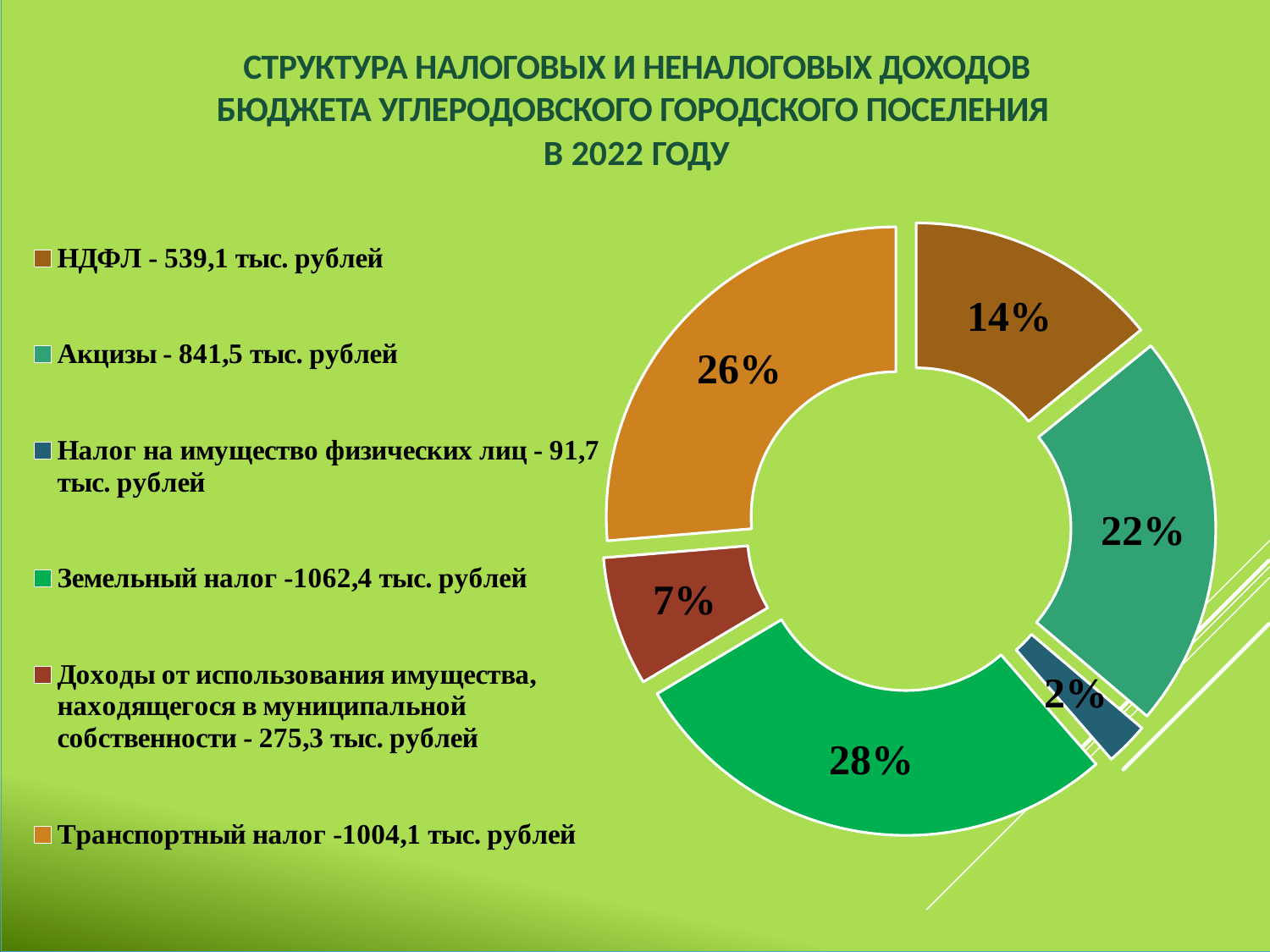
How many categories does the chart show? 6 What percentage is shown for НДФЛ? 14% What share of the chart does Земельный налог account for? 28% What kind of chart is shown on the slide? Doughnut (pie) chart What is the difference in percentage points between the share for Земельный налог and the share for Транспортный налог? 2 percentage points According to the legend, what is the amount for Акцизы? 841,5 тыс. рублей What percentage is shown for Транспортный налог? 26% Which is larger: the share for Транспортный налог or the share for Акцизы? Транспортный налог What percentage is shown for Акцизы? 22% Which category has the smallest share of the chart? Налог на имущество физических лиц What year does the chart title refer to? 2022 Which category has the largest share of the chart? Земельный налог